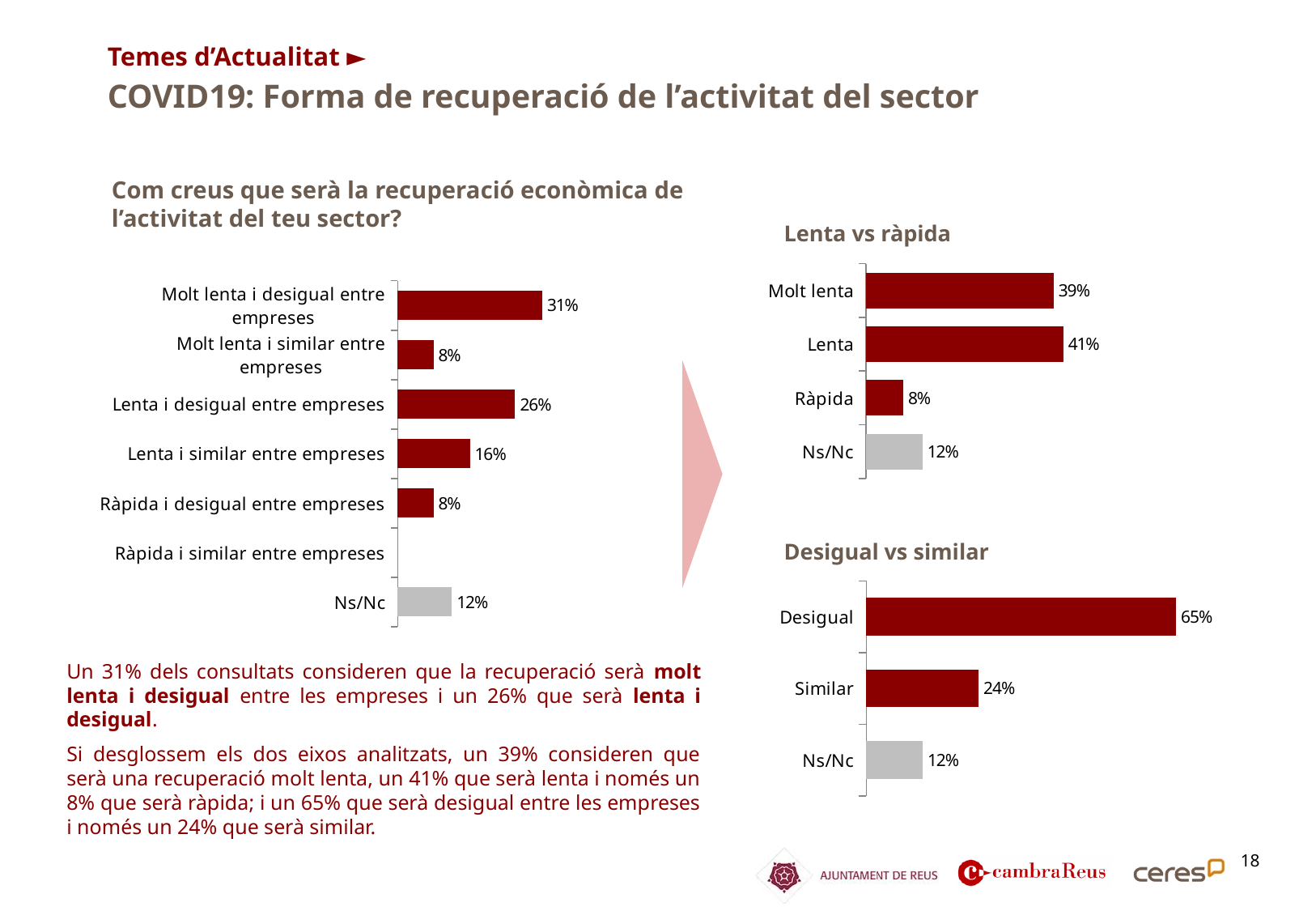
In the left chart ("Com creus que serà la recuperació econòmica de l'activitat del teu sector?"), how many categories are listed? 7 In the "Lenta vs ràpida" chart, what is the value for "Molt lenta"? 39% In the "Lenta vs ràpida" chart, how many categories are shown? 4 In the "Desigual vs similar" chart, what is the value for "Desigual"? 65% In the left chart ("Com creus que serà la recuperació econòmica de l'activitat del teu sector?"), what is the value for "Ns/Nc"? 12% In the "Lenta vs ràpida" chart, which is larger, "Molt lenta" or "Lenta"? Lenta In the "Lenta vs ràpida" chart, which category has the lowest value? Ràpida What type of chart is the "Desigual vs similar" chart? Bar chart In the left chart ("Com creus que serà la recuperació econòmica de l'activitat del teu sector?"), what is the value for "Lenta i desigual entre empreses"? 26% In the left chart ("Com creus que serà la recuperació econòmica de l'activitat del teu sector?"), which category has the highest value? Molt lenta i desigual entre empreses In the left chart ("Com creus que serà la recuperació econòmica de l'activitat del teu sector?"), what is the difference between "Molt lenta i desigual entre empreses" and "Lenta i similar entre empreses"? 15% In the "Desigual vs similar" chart, what is the difference between "Desigual" and "Similar"? 41%